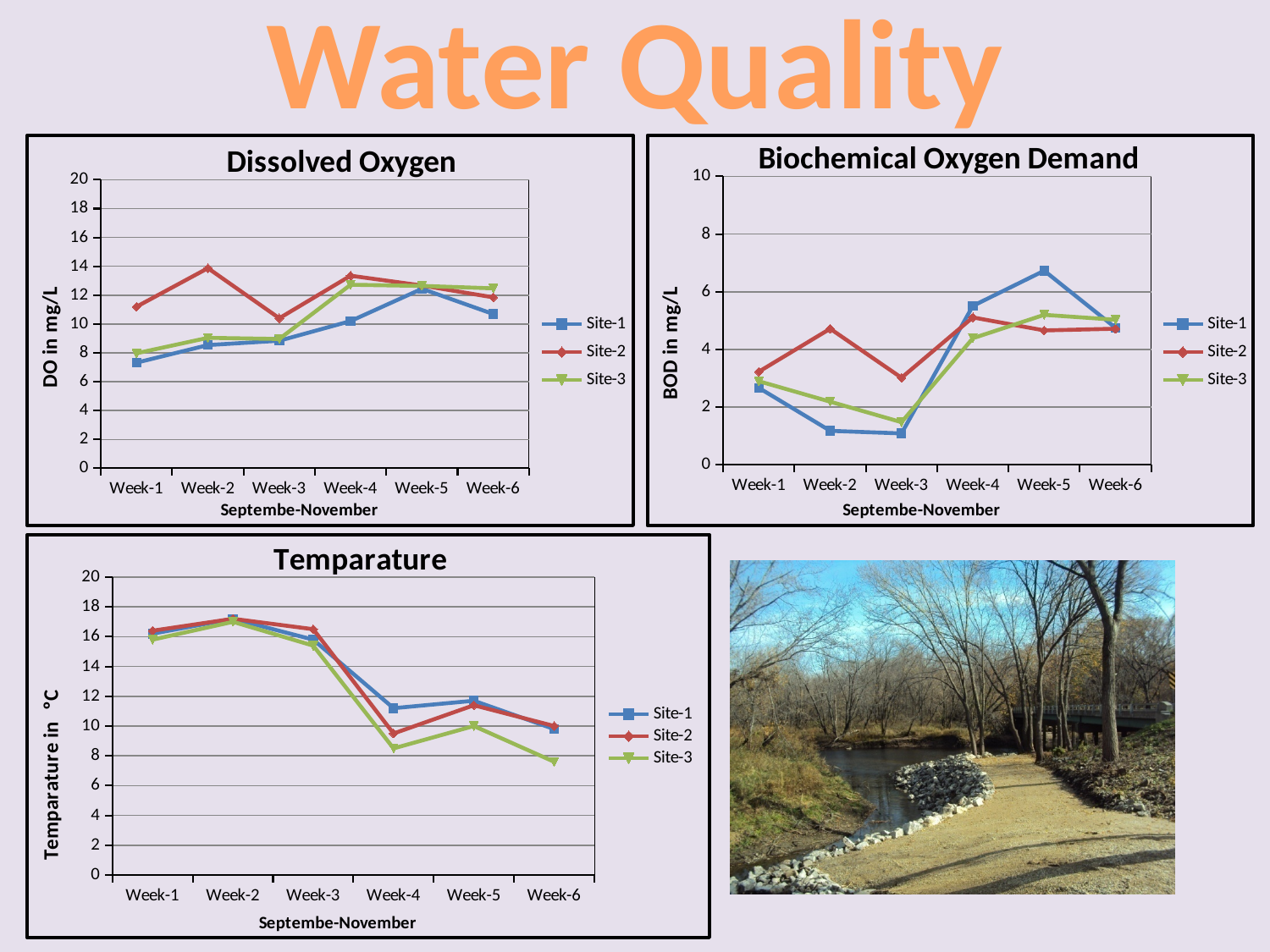
In the Biochemical Oxygen Demand chart, is the Site-1 value at Week-5 greater or less than 6? greater In the Temparature chart, do the values generally rise or fall from Week-1 to Week-6? fall In the Dissolved Oxygen chart, at which week does Site-2 reach its highest value? Week-2 In the Temparature chart, is the Site-3 value at Week-6 greater or less than 8? less What is the x-axis title of the Temparature chart? Septembe-November In the Biochemical Oxygen Demand chart, is the Site-1 value at Week-3 greater or less than 2? less How many series does the legend of the Biochemical Oxygen Demand chart list? 3 In the Biochemical Oxygen Demand chart, at which week does Site-1 reach its highest value? Week-5 How many weeks are shown on the x axis of the Temparature chart? 6 What kind of chart is the Dissolved Oxygen chart? line chart